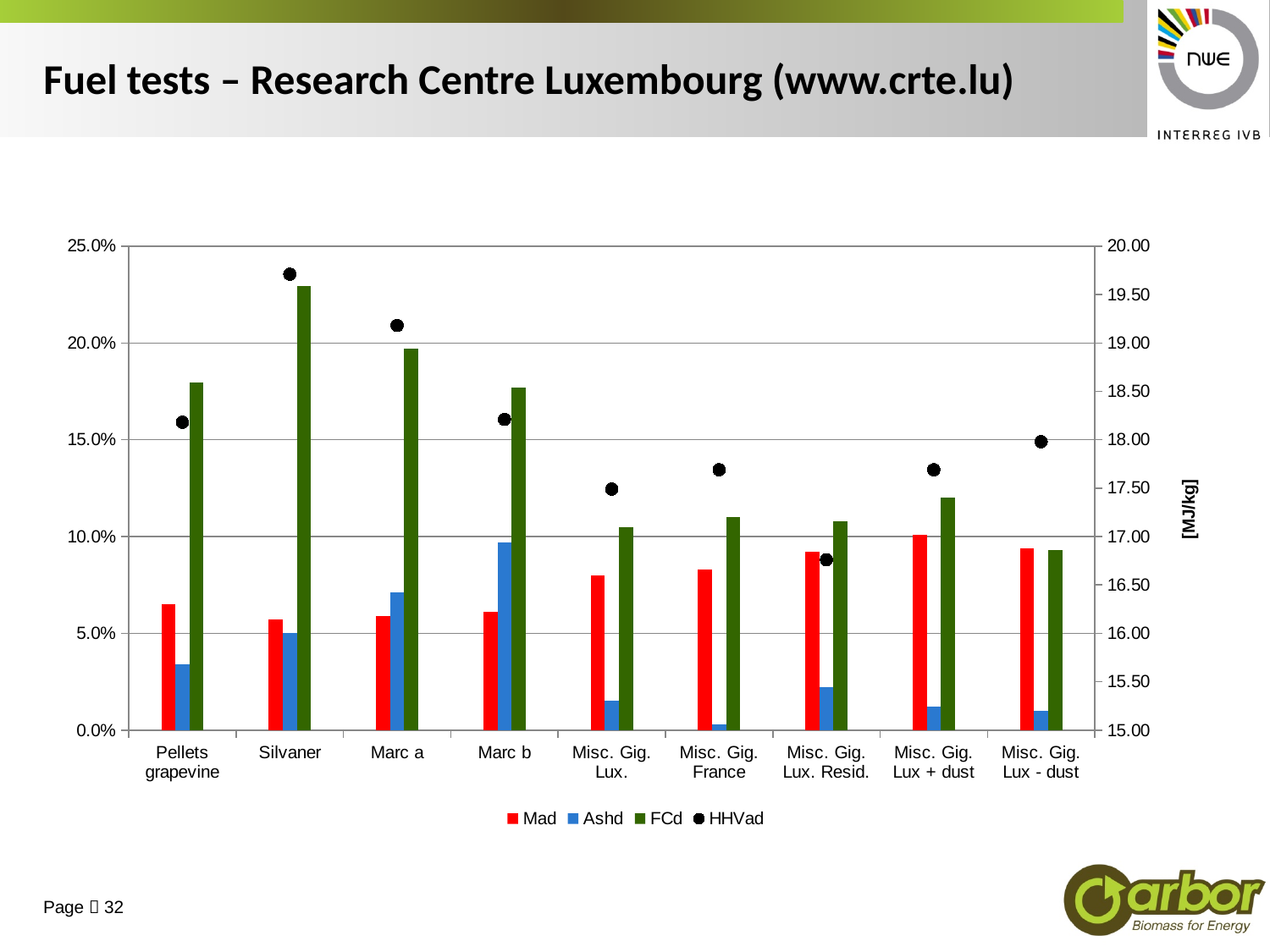
How many categories are shown on the x axis of the chart? 9 Which category has the highest Ashd value? Marc b Which category has the highest HHVad value? Silvaner What kind of chart is shown on the slide? bar chart Which category has the lowest FCd value? Misc. Gig. Lux - dust Which category has the lowest Ashd value? Misc. Gig. France Is the FCd value for Silvaner greater or less than 20.0%? greater Which category has the highest FCd value? Silvaner Which is larger, the FCd value for Marc a or for Marc b? Marc a What unit is shown on the right-hand vertical axis label? [MJ/kg] Is the Ashd value for Pellets grapevine greater or less than 5.0%? less How many series does the chart legend list? 4